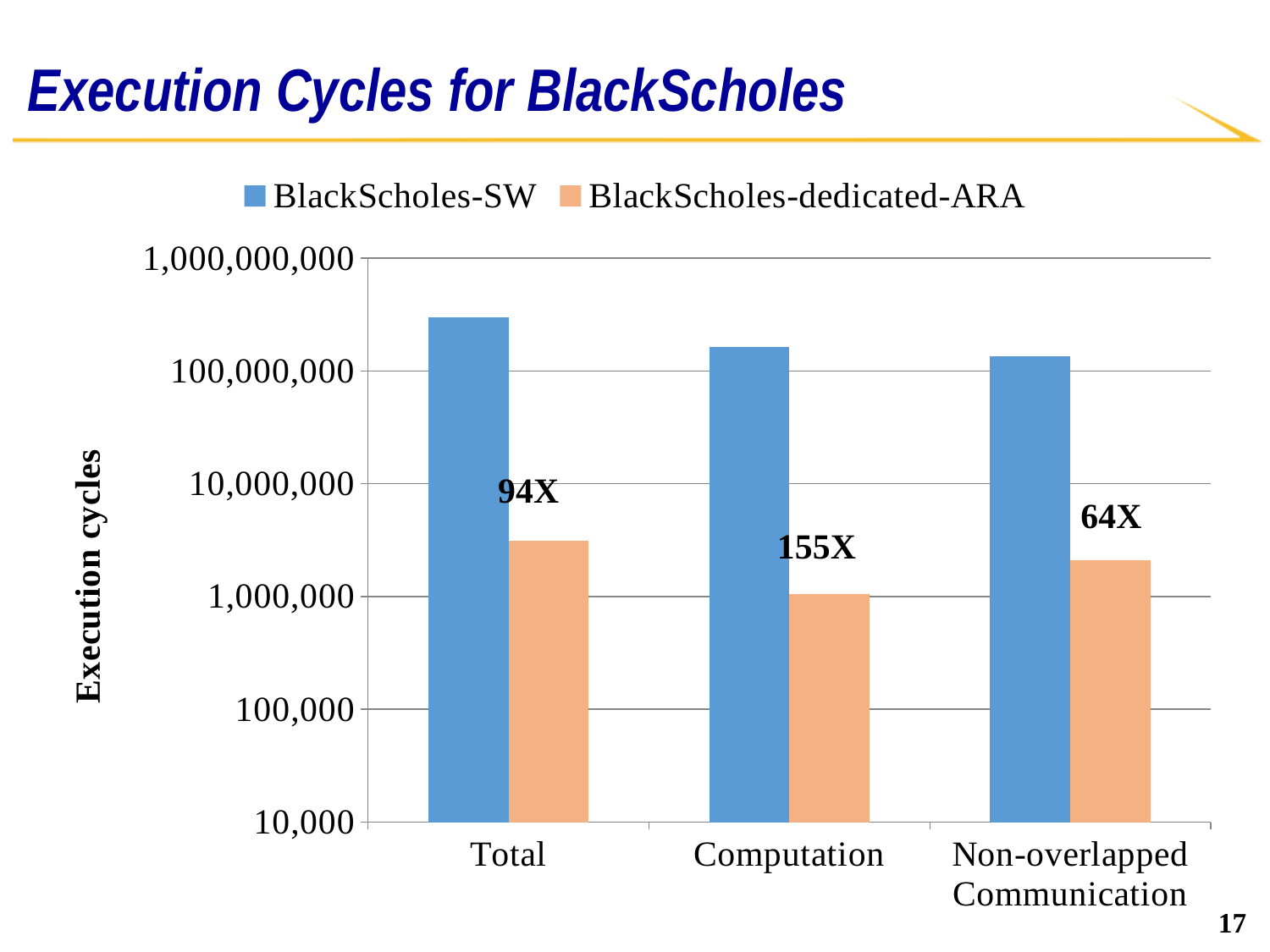
What type of chart is shown on the slide? bar chart Is the BlackScholes-dedicated-ARA value for Non-overlapped Communication greater or less than 10,000,000? less Which category has the lowest value for BlackScholes-dedicated-ARA? Computation Is the BlackScholes-dedicated-ARA value for Total greater or less than 1,000,000? greater What is the label on the vertical axis? Execution cycles How many categories are shown on the x axis? 3 For the Total category, which series has the larger value, BlackScholes-SW or BlackScholes-dedicated-ARA? BlackScholes-SW What speedup label is printed for the Computation category? 155X What is the title of the slide's chart? Execution Cycles for BlackScholes How many series does the legend list? 2 Is the BlackScholes-SW value for Total greater or less than 100,000,000? greater Which category has the highest value for BlackScholes-SW? Total